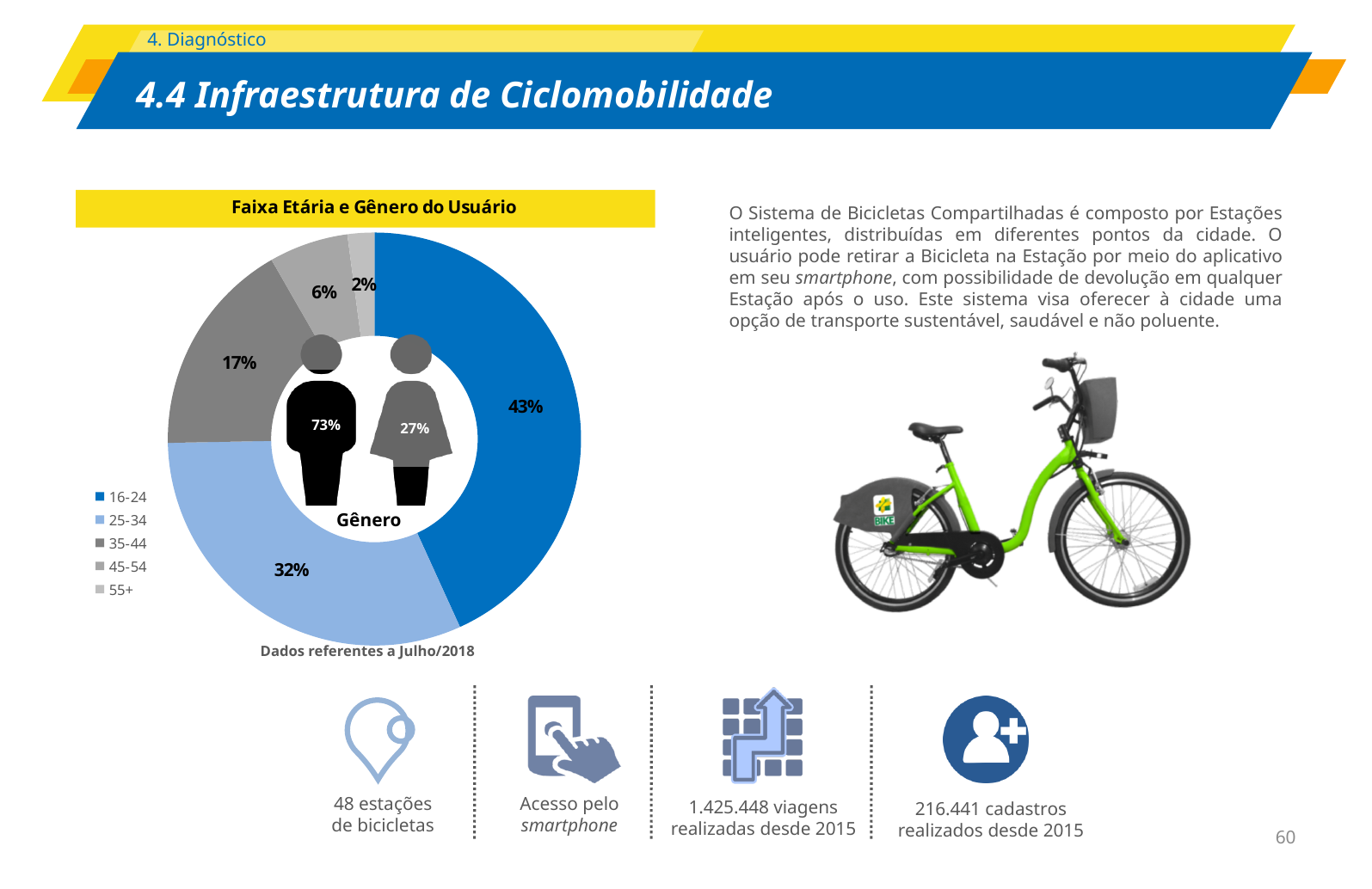
What share of users are in the 35-44 age group? 17% What is the difference in percentage points between the 16-24 and 25-34 age groups? 11 Which age group has a larger share, 35-44 or 45-54? 35-44 What share of users are in the 45-54 age group? 6% What kind of chart is used to show the age distribution of users? Doughnut chart What share of users are in the 16-24 age group? 43% Which age group has the largest share of users? 16-24 What is the title of the chart? Faixa Etária e Gênero do Usuário How many age groups does the legend list? 5 What share of users are in the 25-34 age group? 32% Which age group has the smallest share of users? 55+ What share of users are aged 55+? 2%